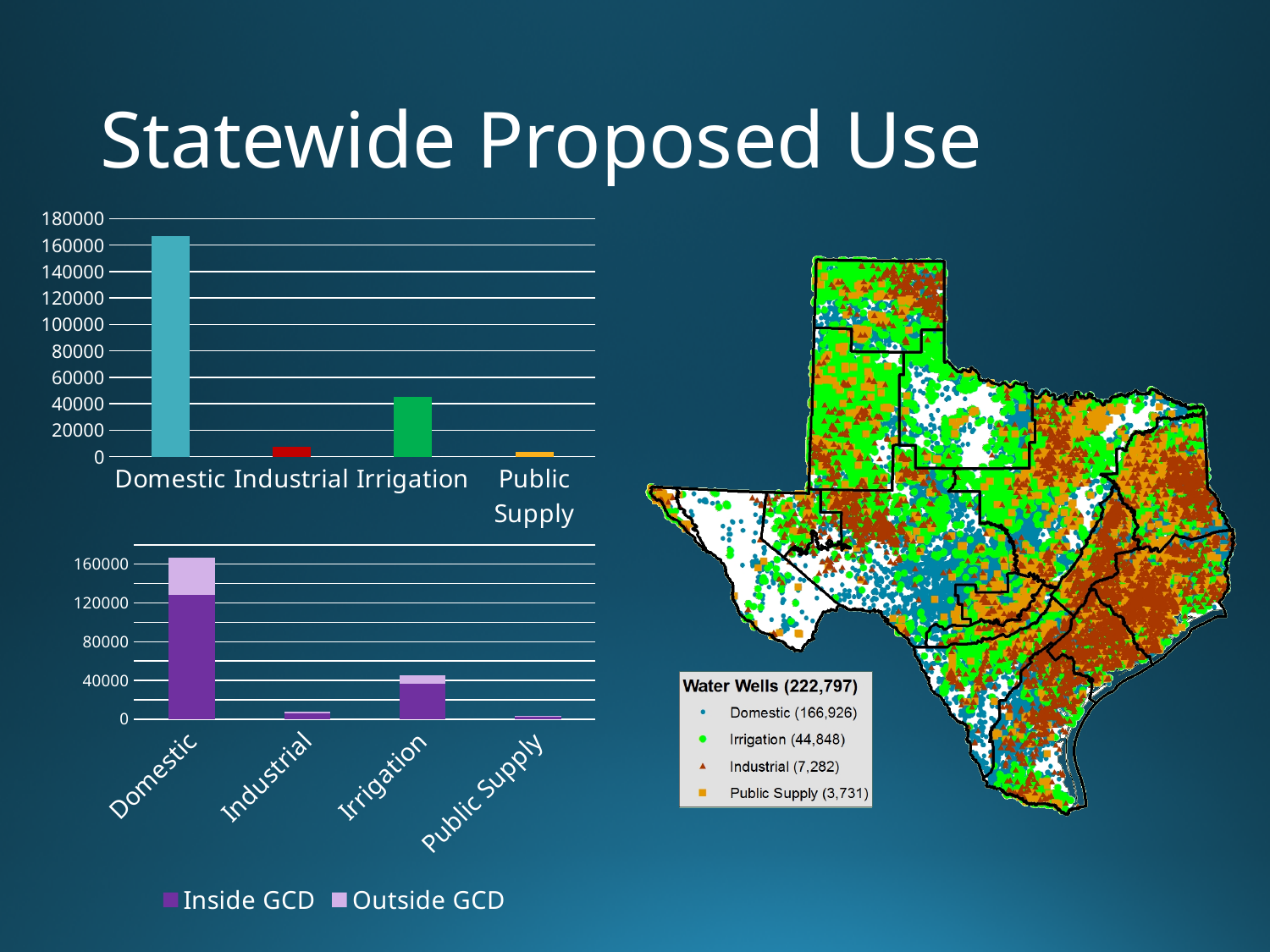
In the bottom chart, is the Inside GCD value for Domestic greater or less than 120000? greater In the top chart, which category has the highest value? Domestic How many categories are shown on the x axis of the top chart? 4 In the top chart, which category has the lowest value? Public Supply What are the two series named in the legend of the bottom chart? Inside GCD and Outside GCD In the top chart, is the value for Industrial greater or less than 20000? less In the top chart, is the value for Domestic greater or less than 160000? greater How many series does the legend of the bottom chart list? 2 What kind of chart is the top chart on the slide? bar chart In the bottom chart, which category has the tallest stacked bar? Domestic In the top chart, which is larger, the value for Irrigation or the value for Industrial? Irrigation